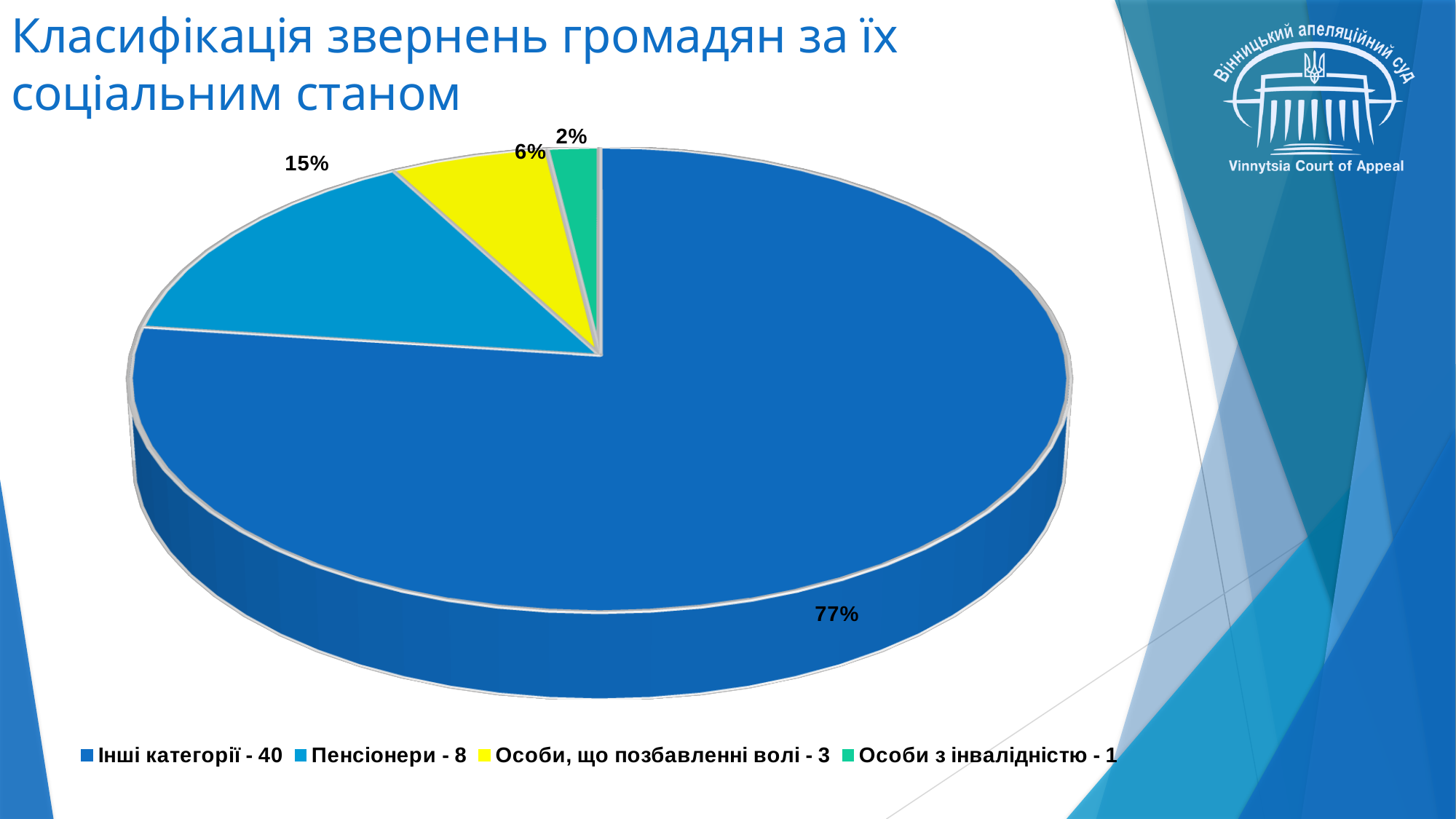
Which category has the largest slice of the pie? Інші категорії - 40 What is the title of the slide containing the pie chart? Класифікація звернень громадян за їх соціальним станом What share of the pie does "Особи з інвалідністю - 1" represent? 2% How many categories does the pie chart show? 4 What share of the pie does "Особи, що позбавленні волі - 3" represent? 6% What share of the pie does "Пенсіонери - 8" represent? 15% What is the difference in percentage points between the "Пенсіонери - 8" slice and the "Особи, що позбавленні волі - 3" slice? 9% What colour is the slice for "Особи, що позбавленні волі - 3"? Yellow What kind of chart is shown on the slide? Pie chart Which category has the smallest slice of the pie? Особи з інвалідністю - 1 Which slice is larger: "Пенсіонери - 8" or "Особи з інвалідністю - 1"? Пенсіонери - 8